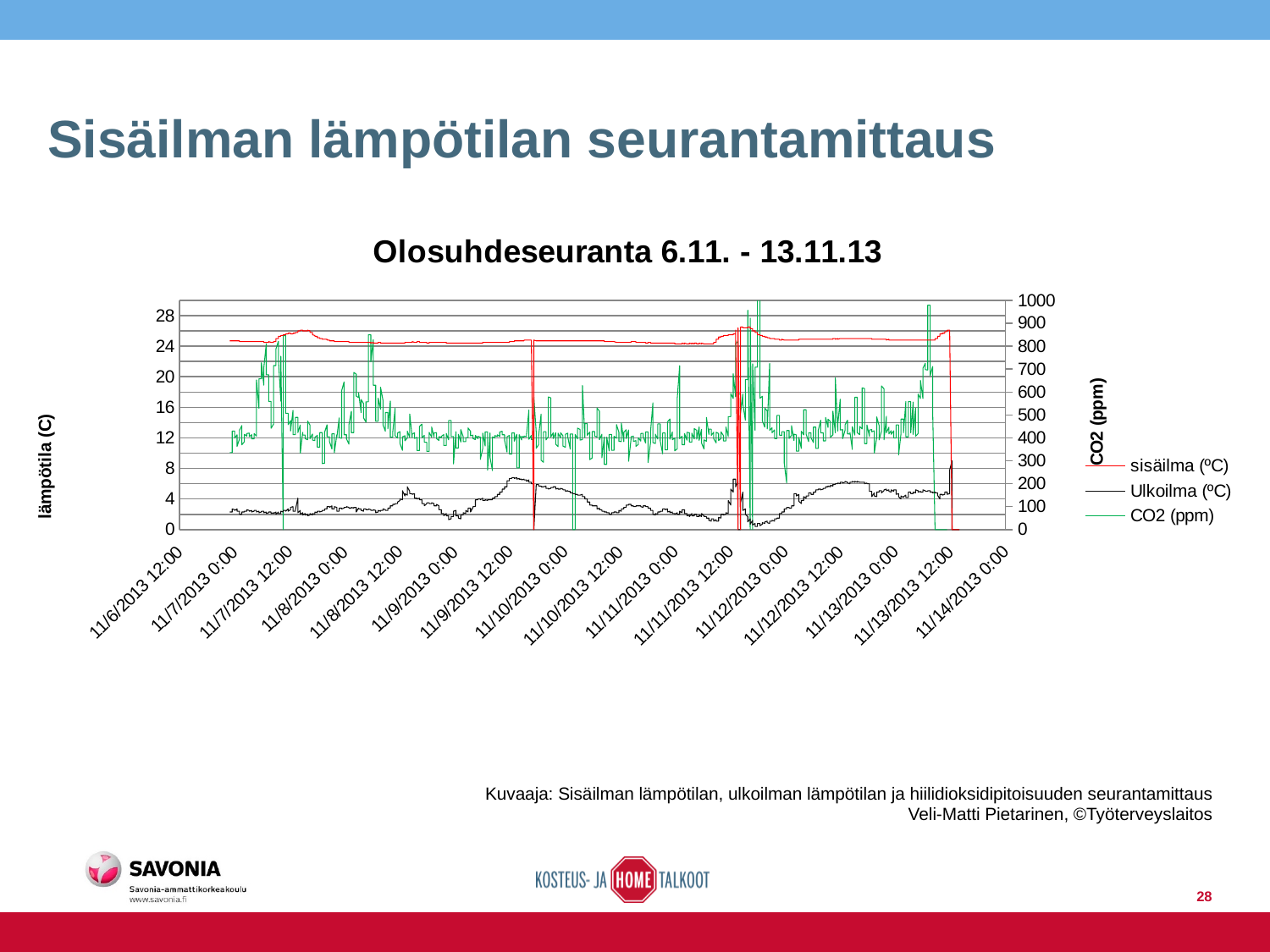
Is the CO2 (ppm) value at 11/9/2013 0:00 greater or less than 600? less How many date-time labels are shown on the x axis? 16 Which series is plotted in red? sisäilma (ºC) Is the value of Ulkoilma (ºC) at 11/9/2013 0:00 greater or less than 8? less What kind of chart is shown on the slide? line chart How many series does the chart legend list? 3 What is the title of the chart? Olosuhdeseuranta 6.11. - 13.11.13 Is the value of sisäilma (ºC) at 11/9/2013 0:00 greater or less than 20? greater Which series has the higher temperature at 11/10/2013 0:00, sisäilma (ºC) or Ulkoilma (ºC)? sisäilma (ºC)